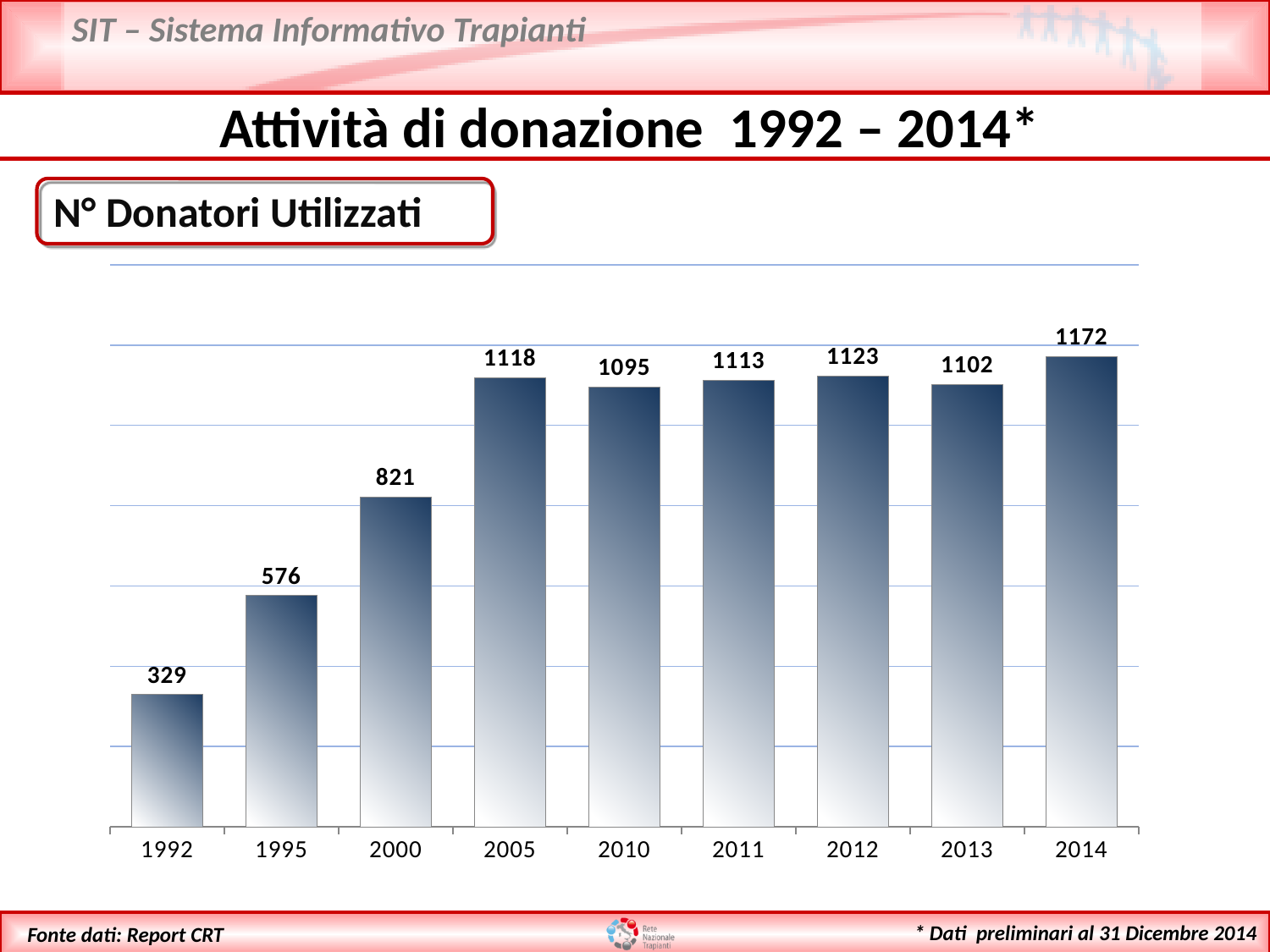
What is the value shown for 2014? 1172 What is the value shown for 1992? 329 What kind of chart is shown on the slide? Bar chart Which year has the highest number of donors used? 2014 Which year has the lowest number of donors used? 1992 How many years are shown on the x axis of the chart? 9 Which is larger, the value for 2012 or the value for 2010? 2012 What is the number of donors used (N° Donatori Utilizzati) in 2000? 821 What is the difference between the values for 2014 and 2013? 70 What is the difference between the values for 2000 and 1995? 245 Do the values rise or fall from 1992 to 2005? Rise What is the title of the slide? Attività di donazione 1992 – 2014*